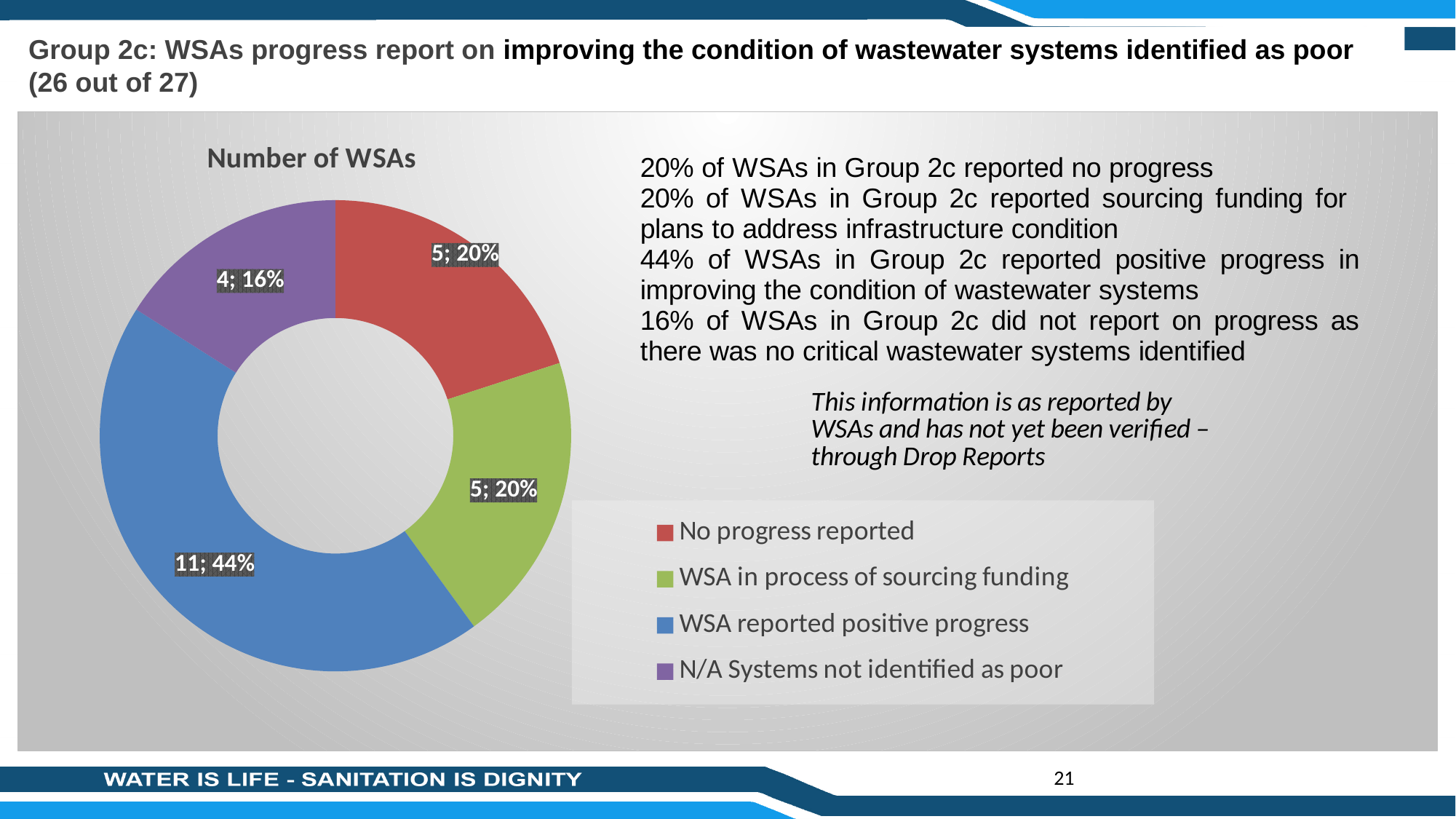
How many WSAs reported positive progress? 11 What share of the chart does 'N/A Systems not identified as poor' represent? 16% Which category has the largest number of WSAs? WSA reported positive progress What type of chart is shown on the slide? Doughnut chart What colour represents 'WSA in process of sourcing funding' in the chart? Green What is the difference between the number of WSAs that reported positive progress and those in process of sourcing funding? 6 How many WSAs fall under 'N/A Systems not identified as poor'? 4 How many categories does the legend list? 4 What share of the chart does 'WSA reported positive progress' represent? 44% How many WSAs are in the 'No progress reported' category? 5 Which category has the smallest number of WSAs? N/A Systems not identified as poor What is the title of the chart? Number of WSAs